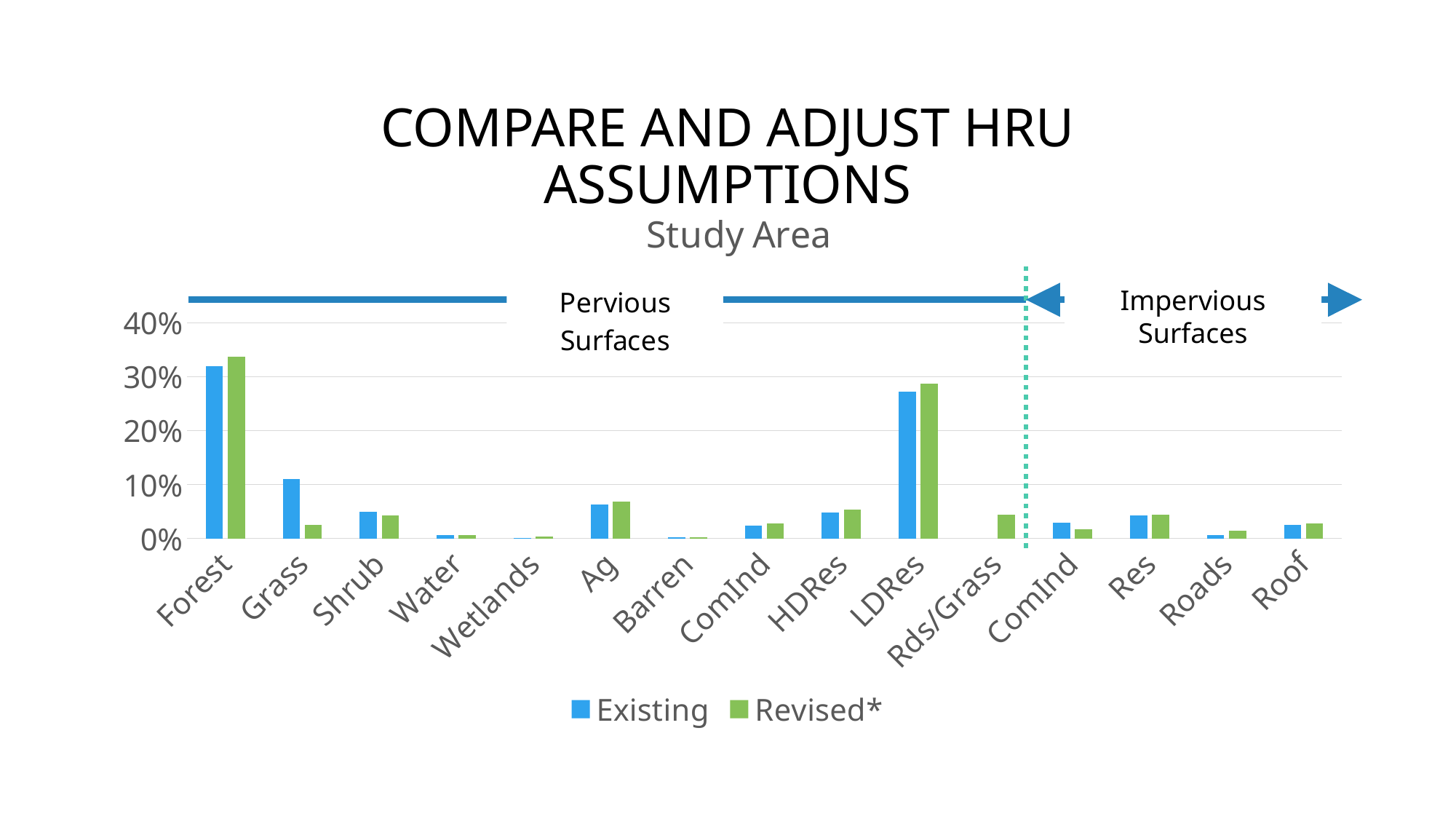
How many categories are shown along the x axis? 15 Is the Existing value for LDRes greater or less than 30%? less How many series does the legend list? 2 Which category has the highest Revised* value? Forest For Grass, which series has the larger value, Existing or Revised*? Existing What are the two series named in the legend? Existing and Revised* Which category has the highest Existing value? Forest Which has the larger Existing value, Forest or LDRes? Forest Is the Existing value for Grass greater or less than 10%? greater Is the Revised* value for Grass greater or less than 10%? less What kind of chart is shown on the slide? bar chart